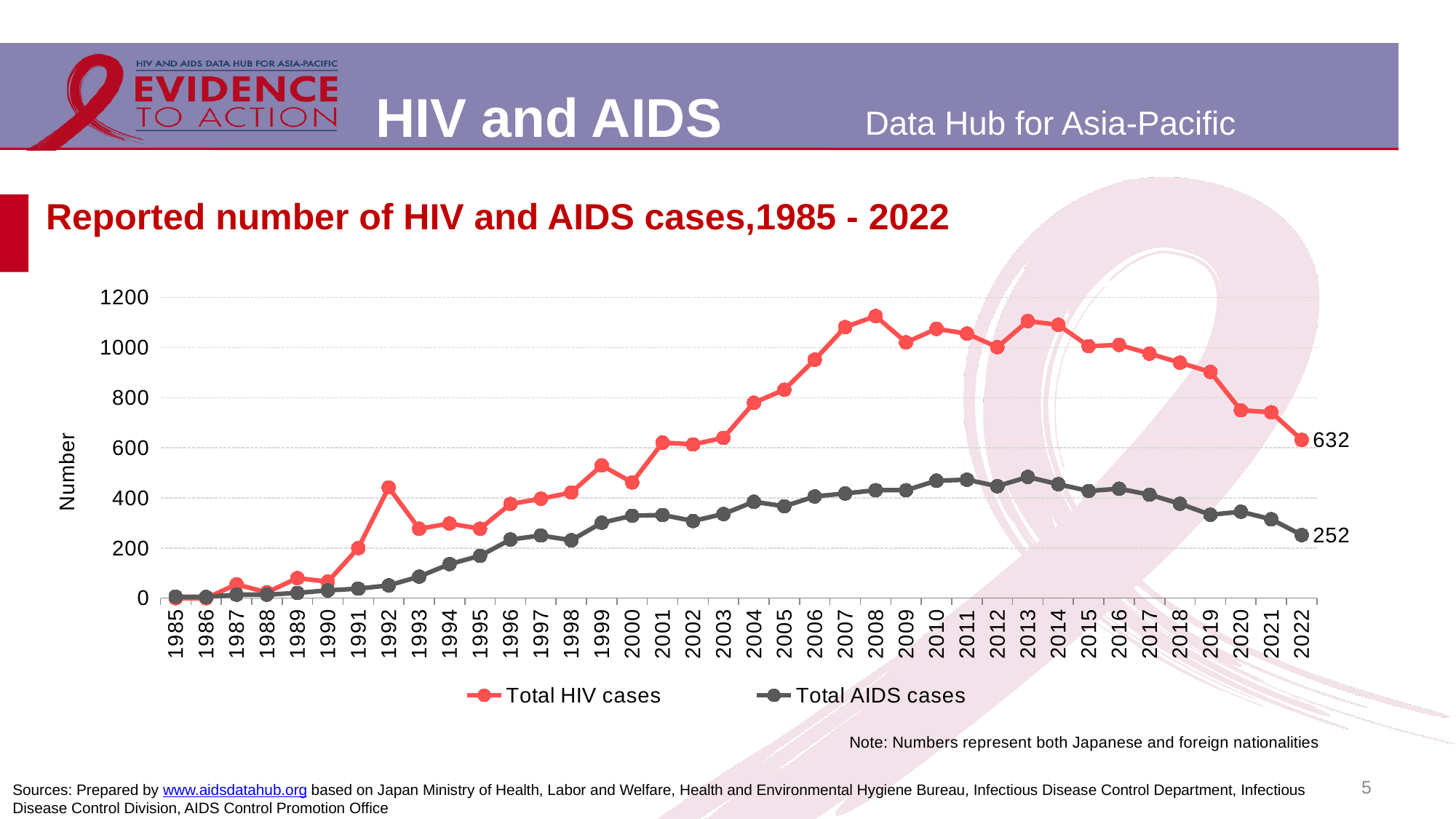
What is the difference between Total HIV cases and Total AIDS cases in 2022? 380 Is the value for Total HIV cases in 2000 greater or less than 600? less How many years are plotted along the x axis? 38 Is the value for Total HIV cases in 2008 greater or less than 1000? greater Is the value for Total AIDS cases in 1990 greater or less than 200? less Do Total HIV cases rise or fall from 2013 to 2022? fall What is the value for Total HIV cases in 2022? 632 What is the value for Total AIDS cases in 2022? 252 What is the title of the y axis? Number How many series does the legend list? 2 What kind of chart is shown on the slide? Line chart In 2022, which is larger: Total HIV cases or Total AIDS cases? Total HIV cases